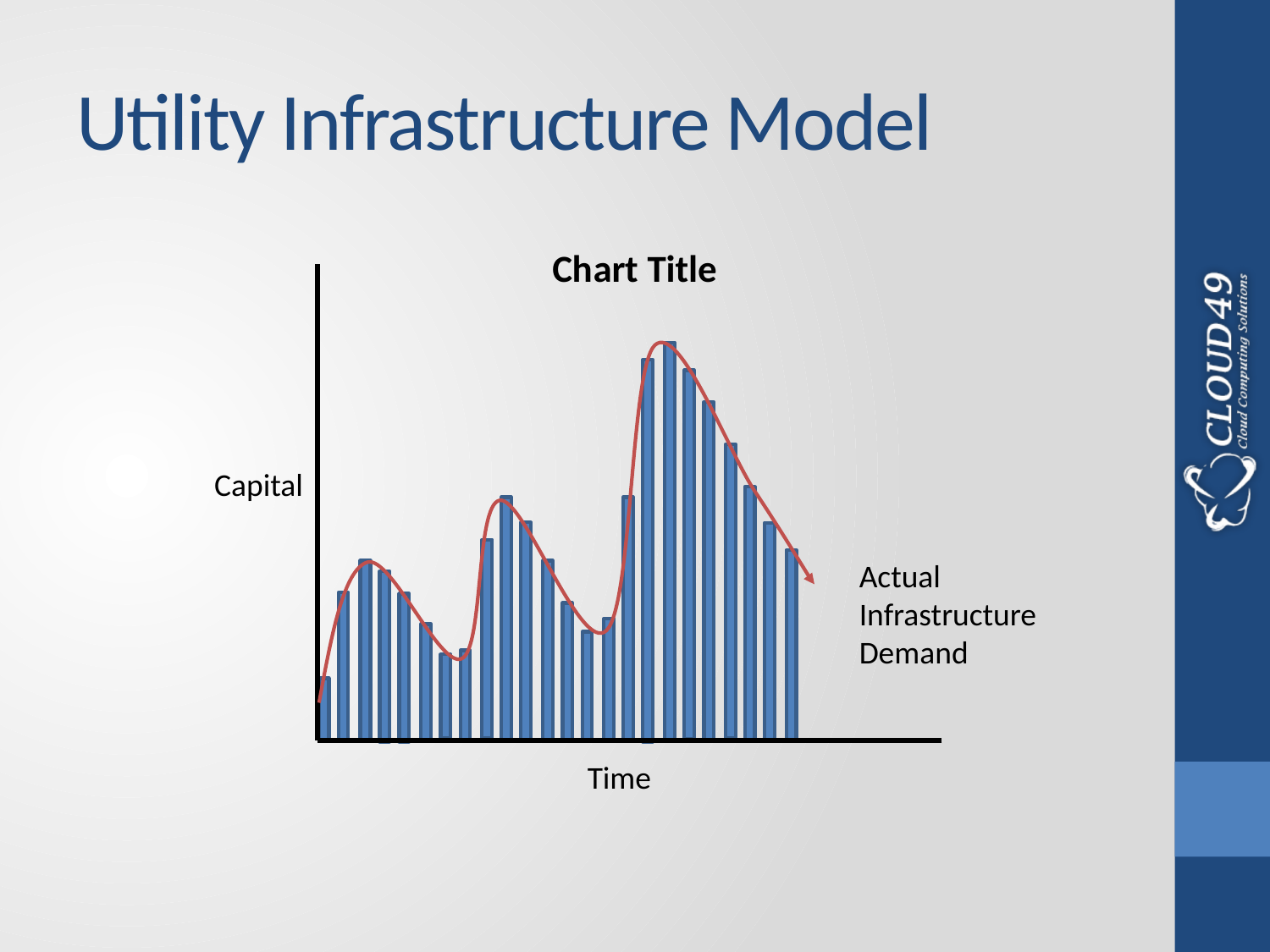
What is the title of the chart? Chart Title The bars form three peaks along the time axis; in which peak (first, second or third) is the tallest bar? third Is the tallest bar in the first peak higher or lower than the tallest bar in the second peak? lower What does the red curve on the chart represent? Actual Infrastructure Demand What kind of chart is shown on the slide? bar chart